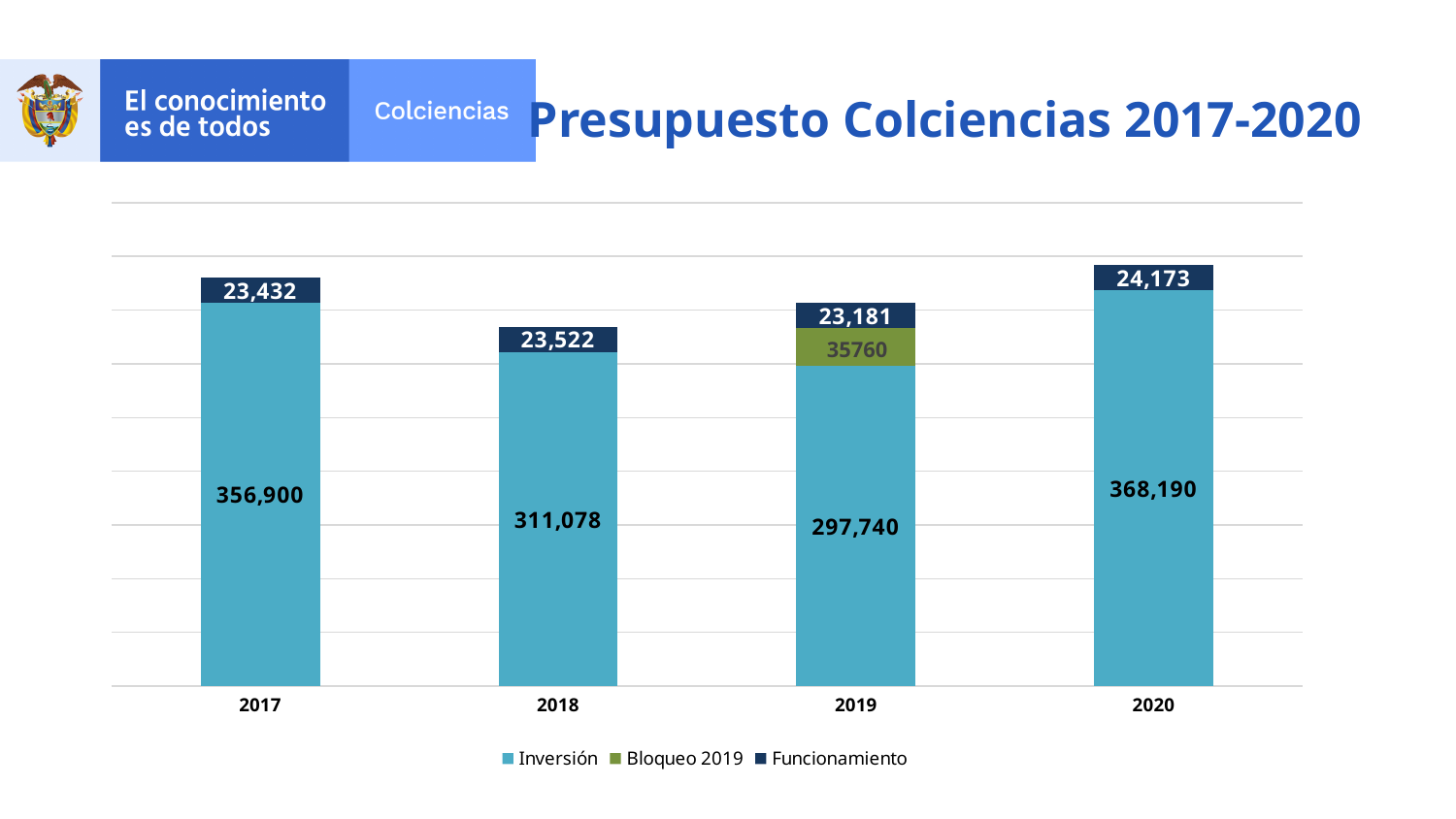
Which year has the highest Inversión value? 2020 What is the Bloqueo 2019 value shown for 2019? 35760 Which year has the lowest Inversión value? 2019 What type of chart is shown on the slide? Stacked bar chart How many series does the legend list? 3 What is the total of the stacked bar for 2019? 356,681 What is the Inversión value for 2018? 311,078 What is the title of the chart? Presupuesto Colciencias 2017-2020 Which is larger, the Funcionamiento value for 2020 or for 2019? 2020 What is the Funcionamiento value for 2017? 23,432 How many years (categories) are shown on the x axis? 4 What is the difference between the Inversión values for 2020 and 2017? 11,290